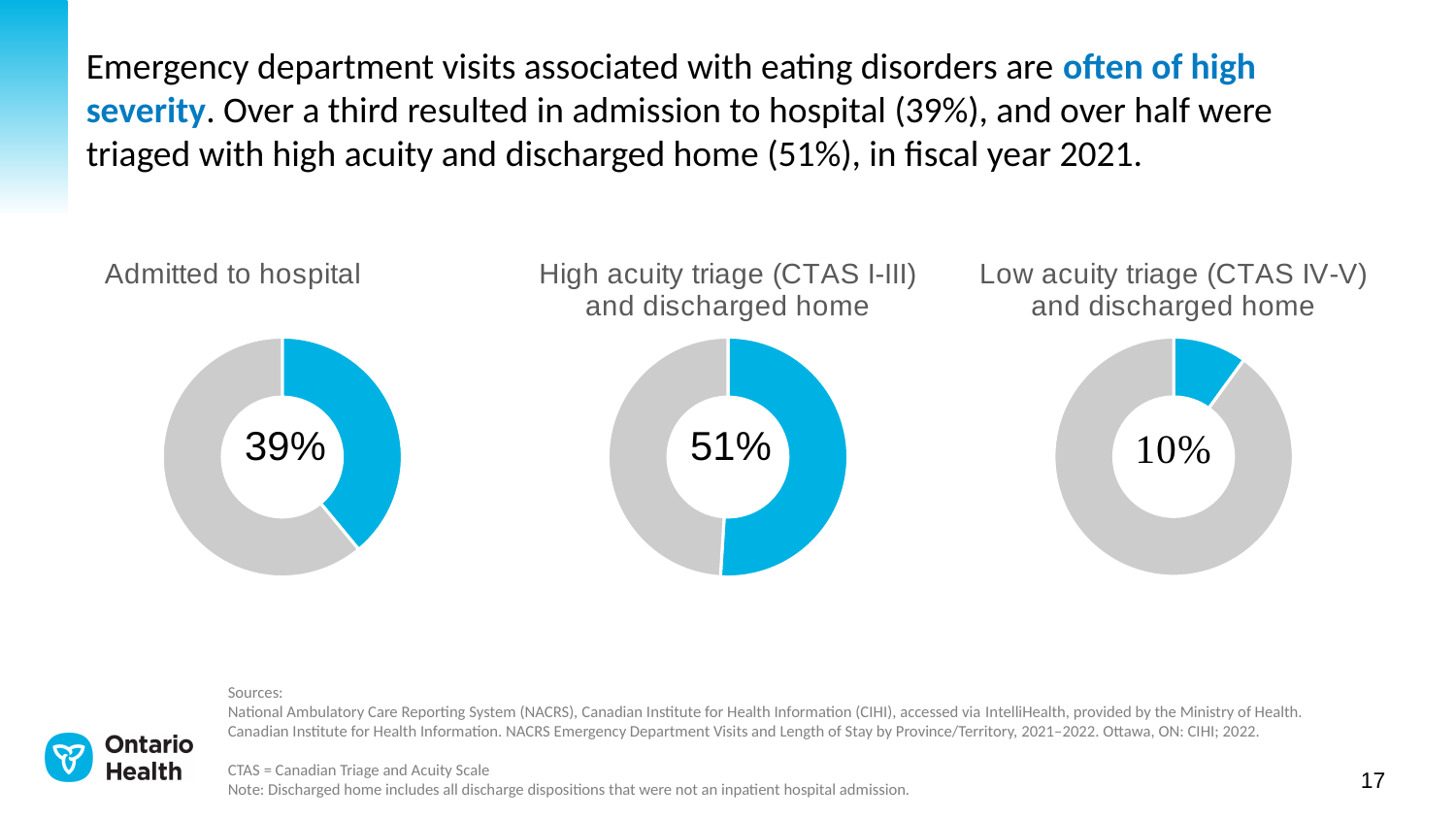
In the 'High acuity triage (CTAS I-III) and discharged home' chart, what percentage is shown? 51% What is the difference between the percentage in the 'Admitted to hospital' chart and the 'Low acuity triage (CTAS IV-V) and discharged home' chart? 29% In the 'Admitted to hospital' chart, what percentage is shown in the centre of the donut? 39% What is the title of the leftmost donut chart on the slide? Admitted to hospital What kind of chart is used to show each of the three percentages on the slide? donut (pie) chart Which of the three donut charts shows the lowest percentage? Low acuity triage (CTAS IV-V) and discharged home Which of the three donut charts shows the highest percentage? High acuity triage (CTAS I-III) and discharged home In the 'Low acuity triage (CTAS IV-V) and discharged home' chart, what colour is the highlighted 10% slice? blue In the 'Low acuity triage (CTAS IV-V) and discharged home' chart, what percentage is shown? 10% Is the percentage in the 'Admitted to hospital' chart larger or smaller than the percentage in the 'Low acuity triage (CTAS IV-V) and discharged home' chart? larger How many donut charts are shown on the slide? 3 What is the difference between the percentage in the 'High acuity triage (CTAS I-III) and discharged home' chart and the 'Admitted to hospital' chart? 12%